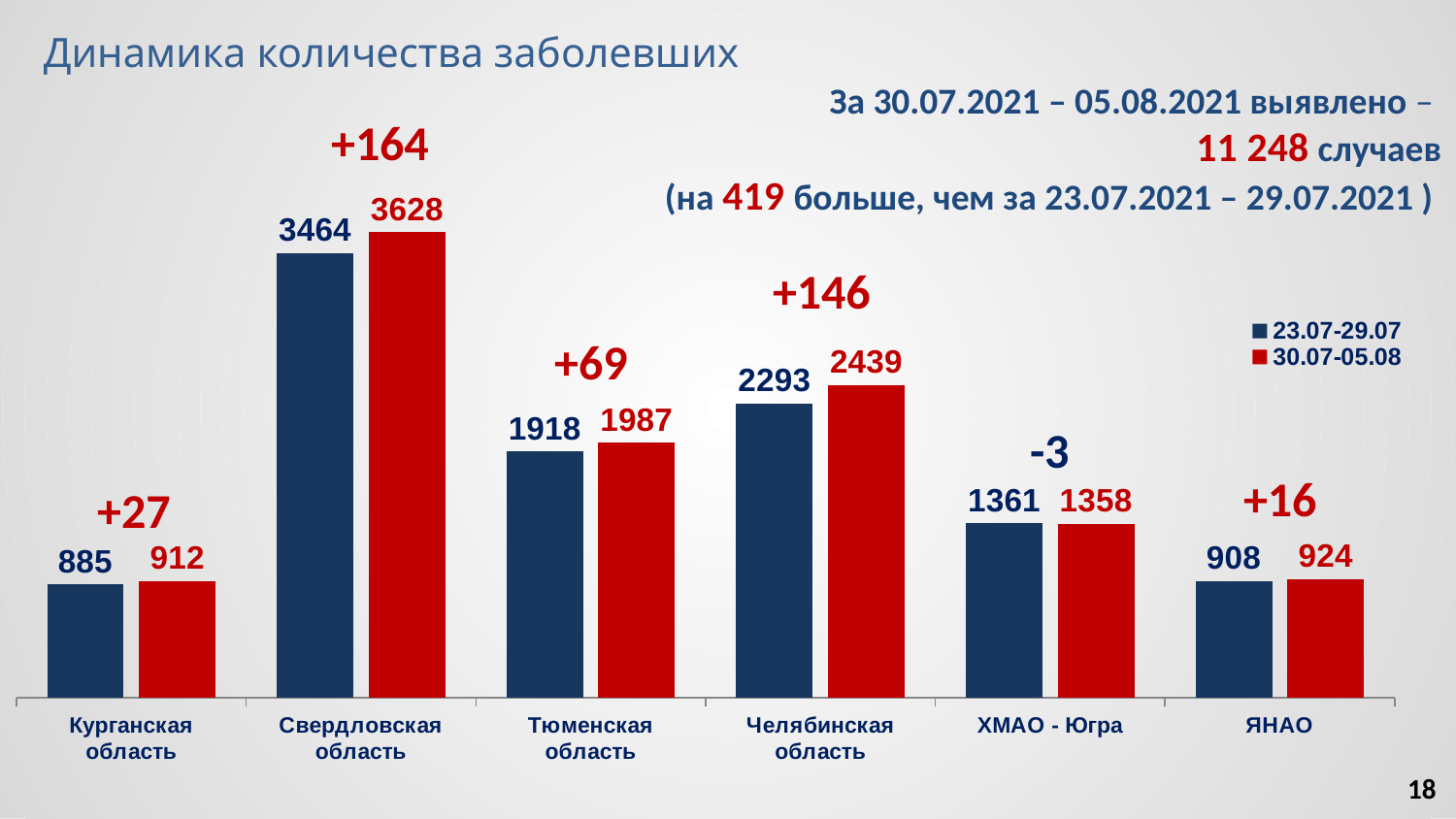
What is the value for Свердловская область in the 30.07-05.08 series? 3628 What is the value for ХМАО - Югра in the 30.07-05.08 series? 1358 Which region has the lowest value in the 23.07-29.07 series? Курганская область What is the difference between the 30.07-05.08 and 23.07-29.07 values for Челябинская область? 146 What kind of chart is shown on the slide? bar chart What is the value for Тюменская область in the 23.07-29.07 series? 1918 What is the difference between the 30.07-05.08 and 23.07-29.07 values for ЯНАО? 16 Which colour represents the 30.07-05.08 series in the legend? red How many regions are shown on the x axis? 6 How many series does the legend list? 2 Which is larger for ХМАО - Югра: the 23.07-29.07 value or the 30.07-05.08 value? 23.07-29.07 Which region has the highest value in the 30.07-05.08 series? Свердловская область